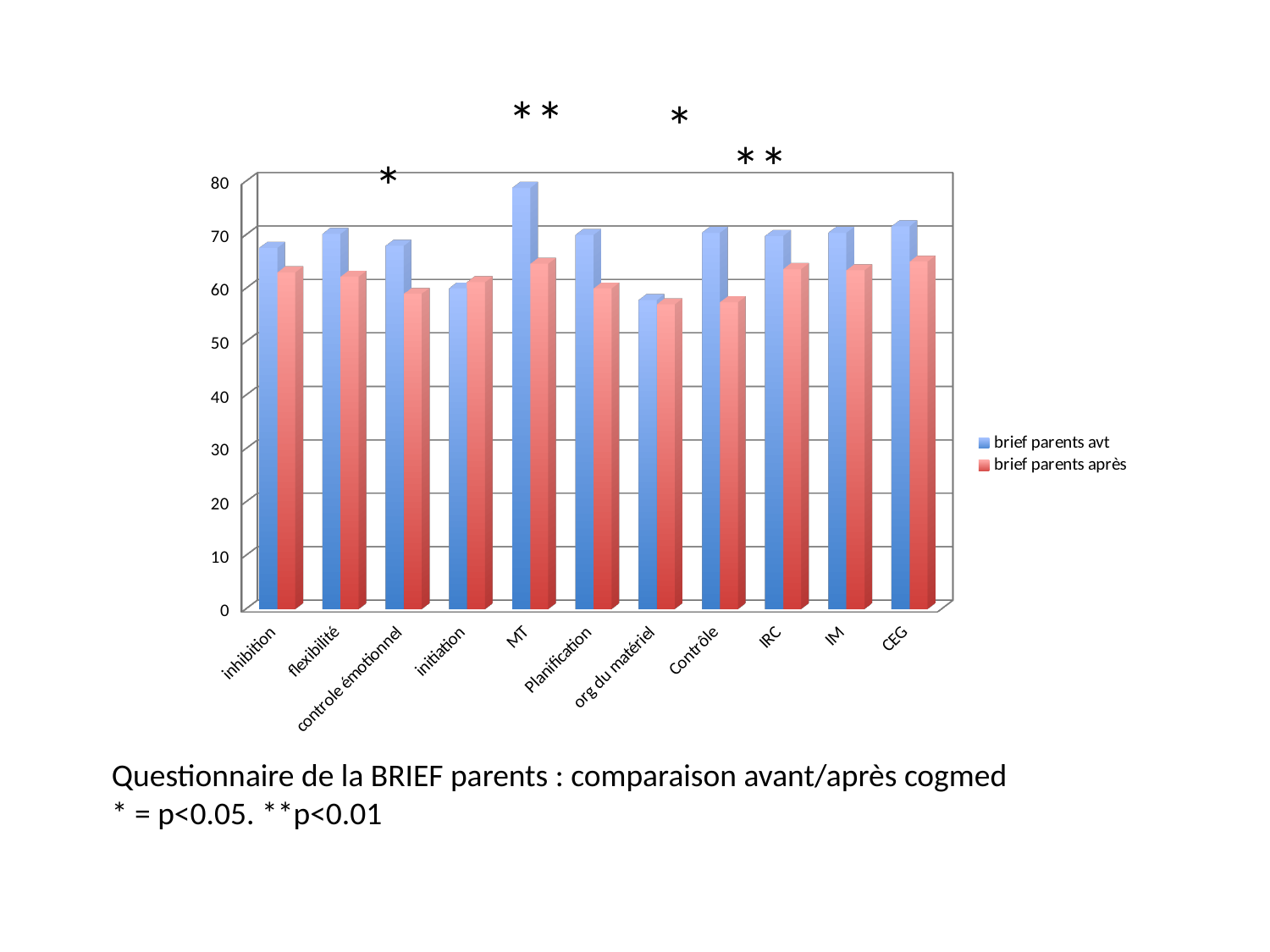
What kind of chart is shown on the slide? bar chart Is the 'brief parents après' value for Contrôle greater or less than 60? less What colour are the bars for the 'brief parents après' series? red How many series does the chart's legend list? 2 Is the 'brief parents avt' value for MT greater or less than 70? greater How many categories are shown along the x axis of the chart? 11 Is the 'brief parents avt' value for org du matériel greater or less than 60? less For Contrôle, which series has the larger value: 'brief parents avt' or 'brief parents après'? brief parents avt For MT, which series has the larger value: 'brief parents avt' or 'brief parents après'? brief parents avt Which category has the highest value for the 'brief parents avt' series? MT Which category has the lowest value for the 'brief parents avt' series? org du matériel